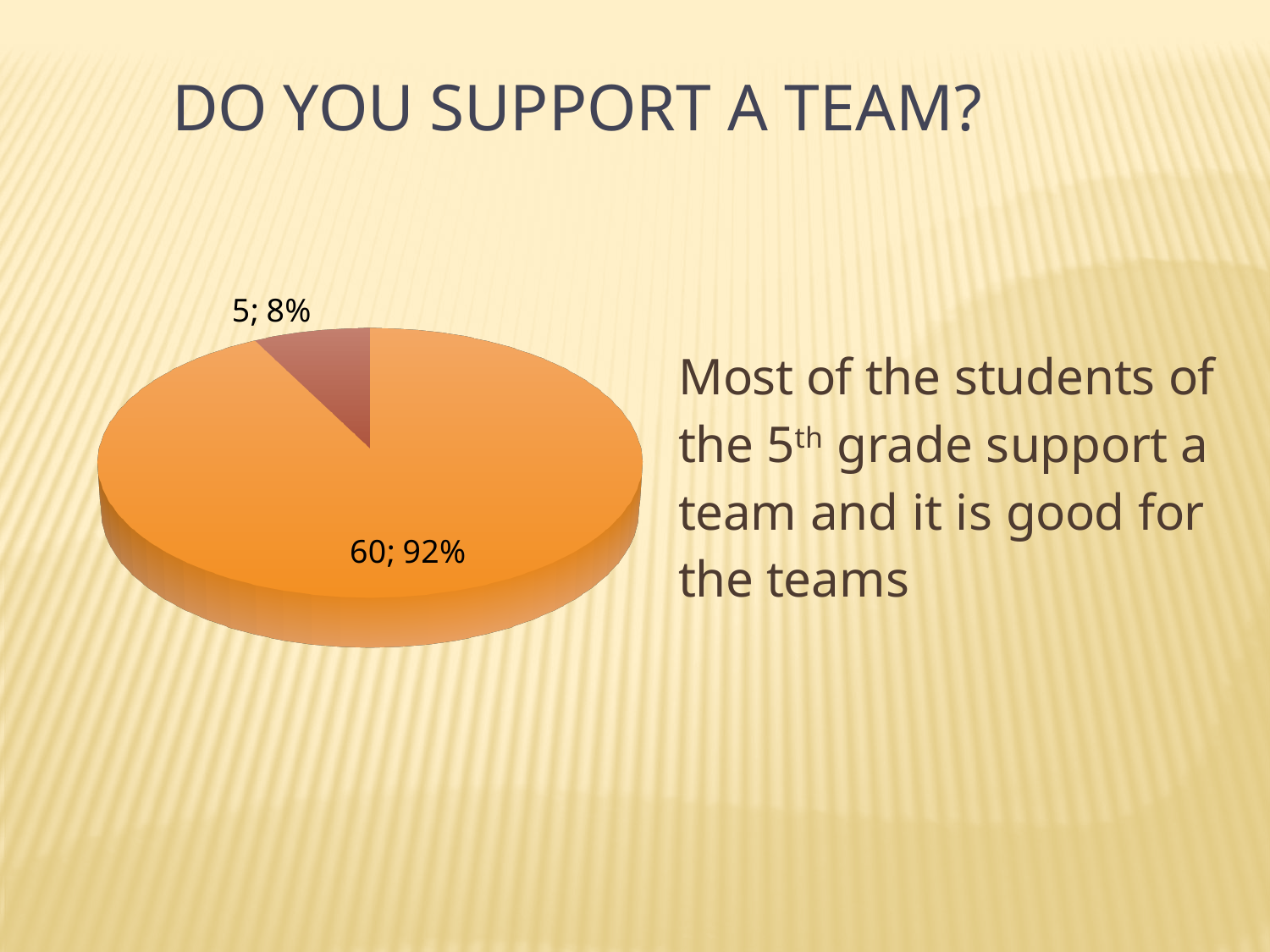
Which slice has the smallest value in the pie chart? the brown slice (5; 8%) What count is shown on the small brown slice of the pie chart? 5 What is the difference between the counts of the orange slice and the brown slice? 55 What is the title of the slide containing the pie chart? DO YOU SUPPORT A TEAM? What percentage share does the small brown slice represent? 8% Is the count for the orange slice greater or less than 50? greater What kind of chart is shown on the slide? pie chart What is the total count across both slices of the pie chart? 65 Which slice is larger, the orange one or the brown one? the orange one What count is shown on the large orange slice of the pie chart? 60 How many slices does the pie chart have? 2 What percentage share does the large orange slice represent? 92%